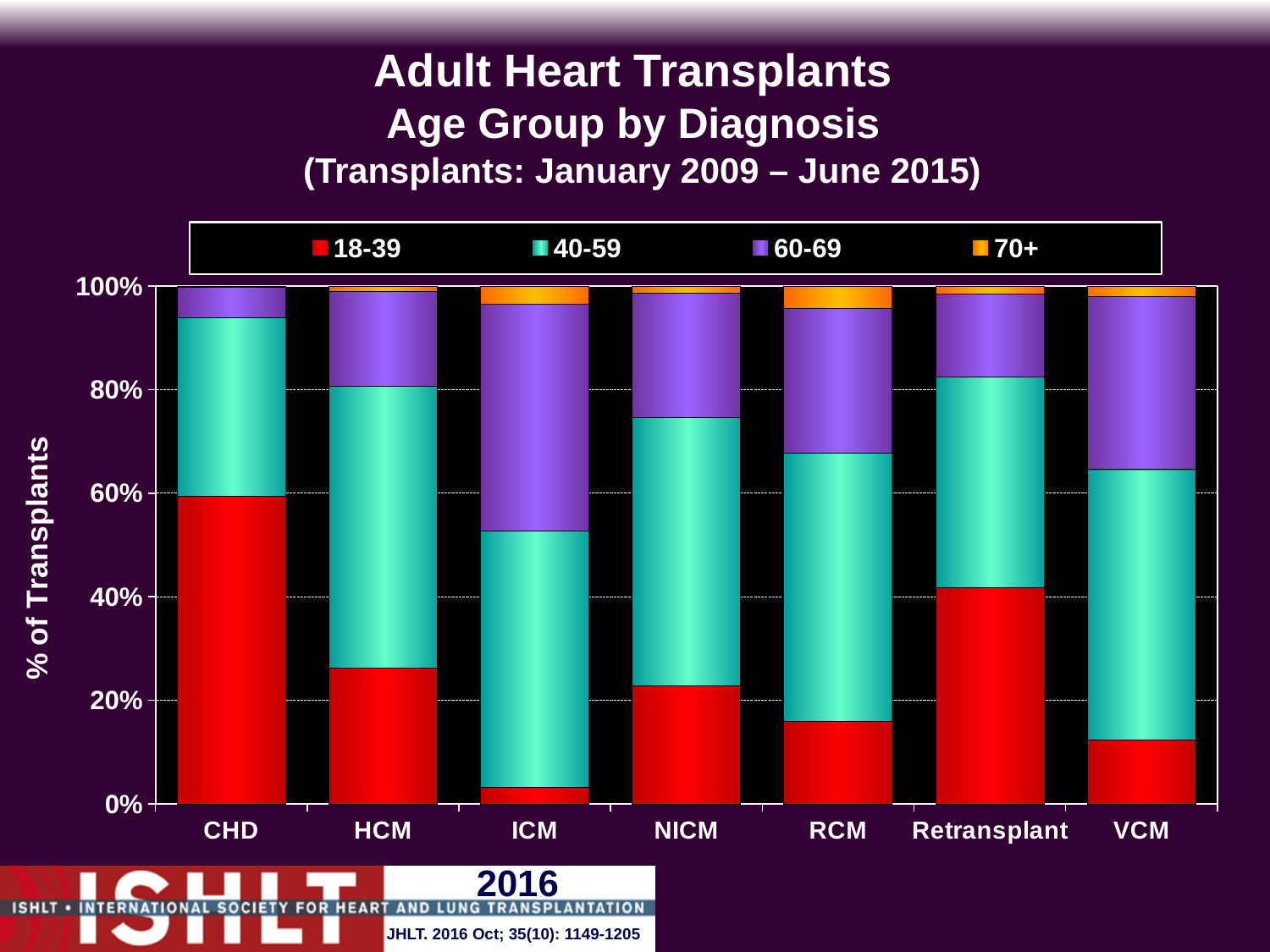
How many diagnosis categories are shown along the x axis? 7 Is the 18-39 share for CHD greater or less than 40%? greater Which diagnosis has the smallest 18-39 share? ICM Is the 18-39 share for ICM greater or less than 20%? less Is the 18-39 share for RCM greater or less than 20%? less Which has the larger 18-39 share, CHD or HCM? CHD Which age group is shown in red in the legend? 18-39 Which diagnosis has the largest 60-69 share? ICM Which has the larger 60-69 share, ICM or NICM? ICM How many age-group series does the legend list? 4 What kind of chart is shown on the slide? Stacked bar chart Which diagnosis has the largest 18-39 share? CHD